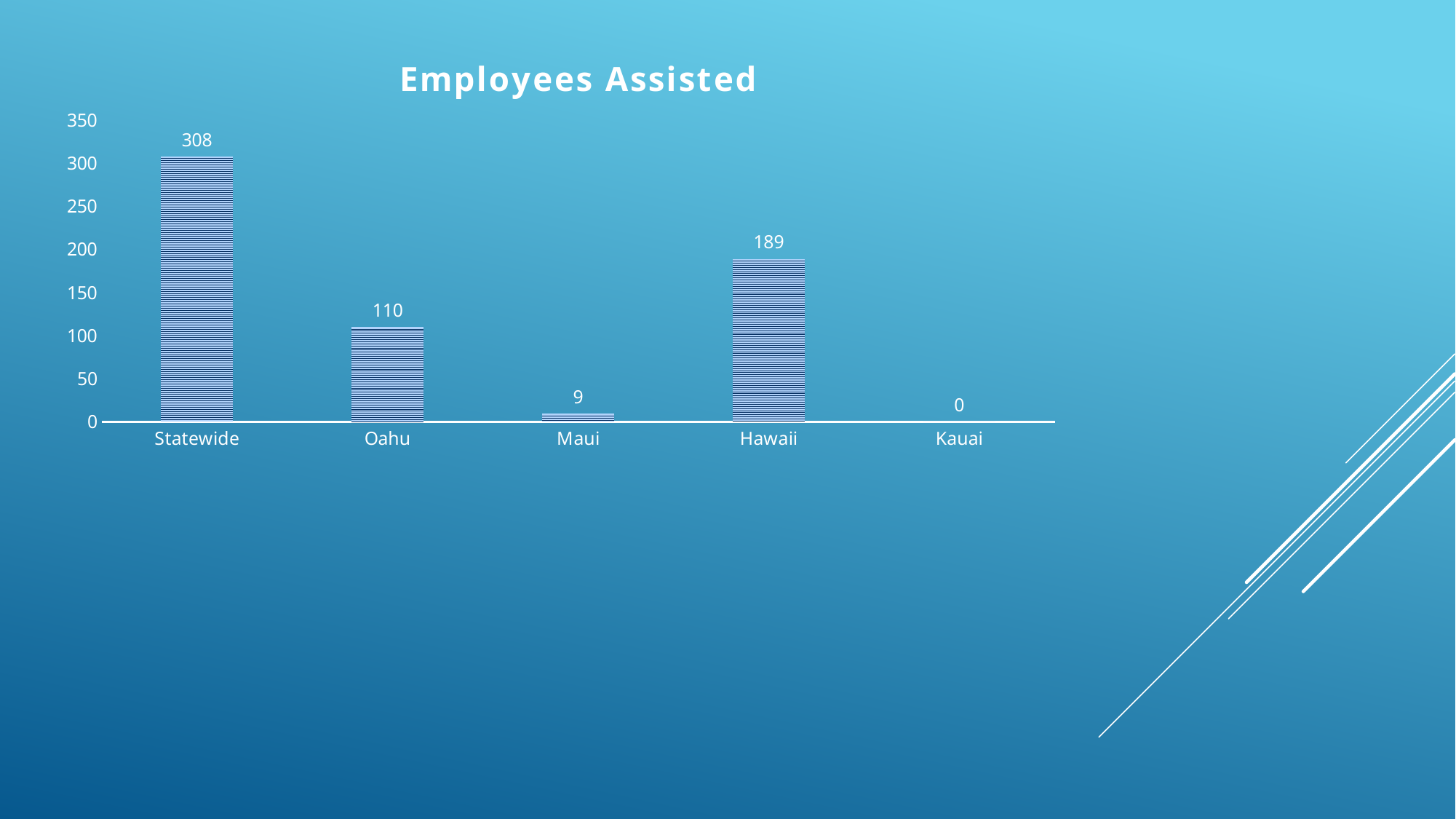
What is the difference between the values for Hawaii and Oahu? 79 What kind of chart is shown on the slide? Bar chart What is the title of the chart? Employees Assisted What is the value shown for Maui? 9 Is the value for Hawaii greater or less than 150? greater Which is larger, the value for Oahu or the value for Hawaii? Hawaii Which category has the lowest value? Kauai How many categories are shown on the x axis? 5 Which category has the highest value? Statewide What is the value shown for Kauai? 0 How many employees were assisted on Oahu? 110 What is the value for Statewide in the Employees Assisted chart? 308